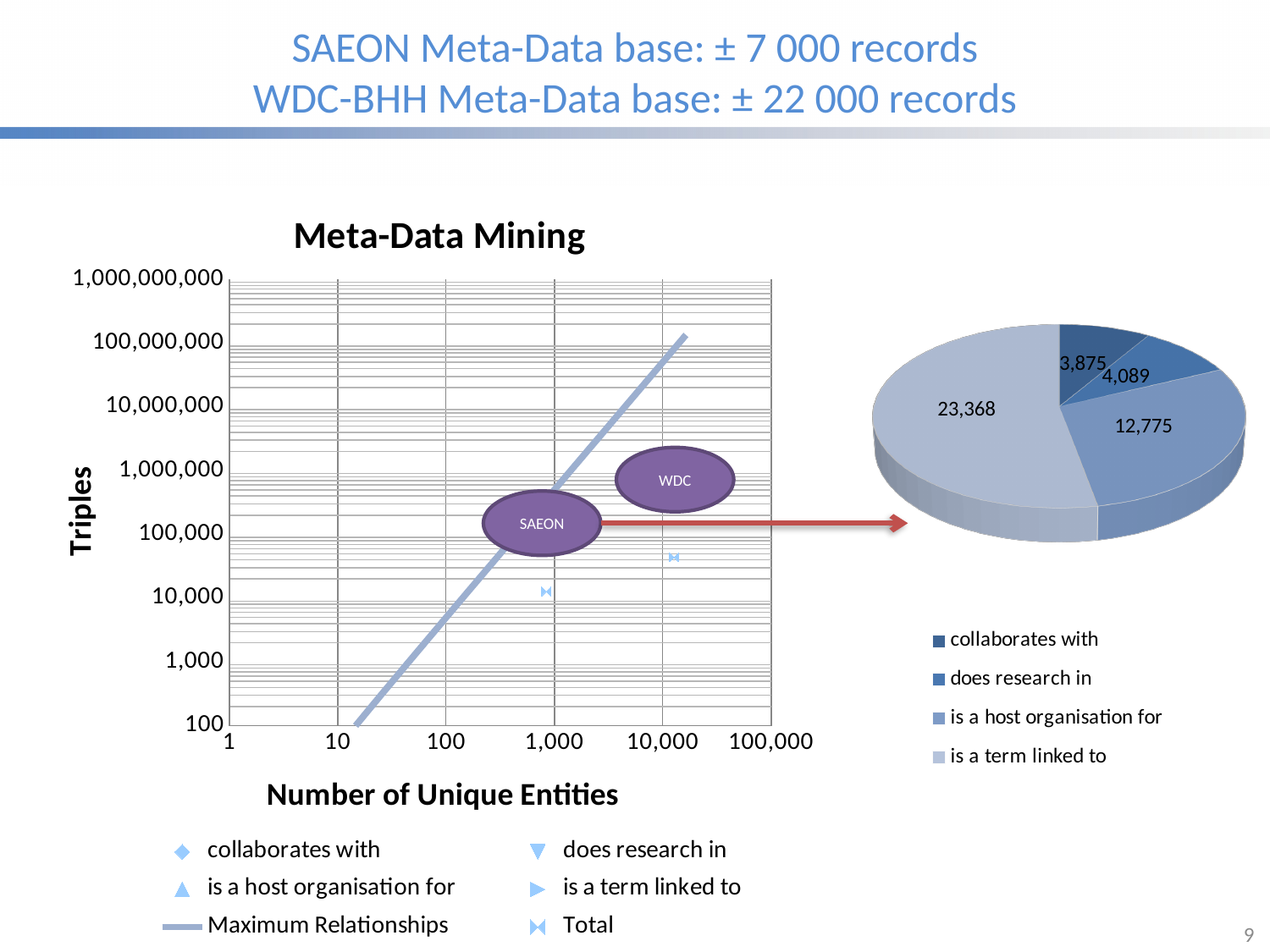
In the pie chart, what is the value for 'is a host organisation for'? 12,775 In the pie chart, which category has the largest slice? is a term linked to In the pie chart, which is larger: 'does research in' or 'collaborates with'? does research in What type of chart is the chart on the right of the slide? pie chart In the 'Meta-Data Mining' chart, what is the label of the vertical axis? Triples How many slices does the pie chart have? 4 In the pie chart, what is the difference between 'is a term linked to' and 'is a host organisation for'? 10,593 In the pie chart, which category has the smallest slice? collaborates with What is the title of the scatter chart on the left? Meta-Data Mining How many entries does the legend of the 'Meta-Data Mining' scatter chart list? 6 In the pie chart, what is the value for 'collaborates with'? 3,875 In the pie chart, what is the value for 'is a term linked to'? 23,368